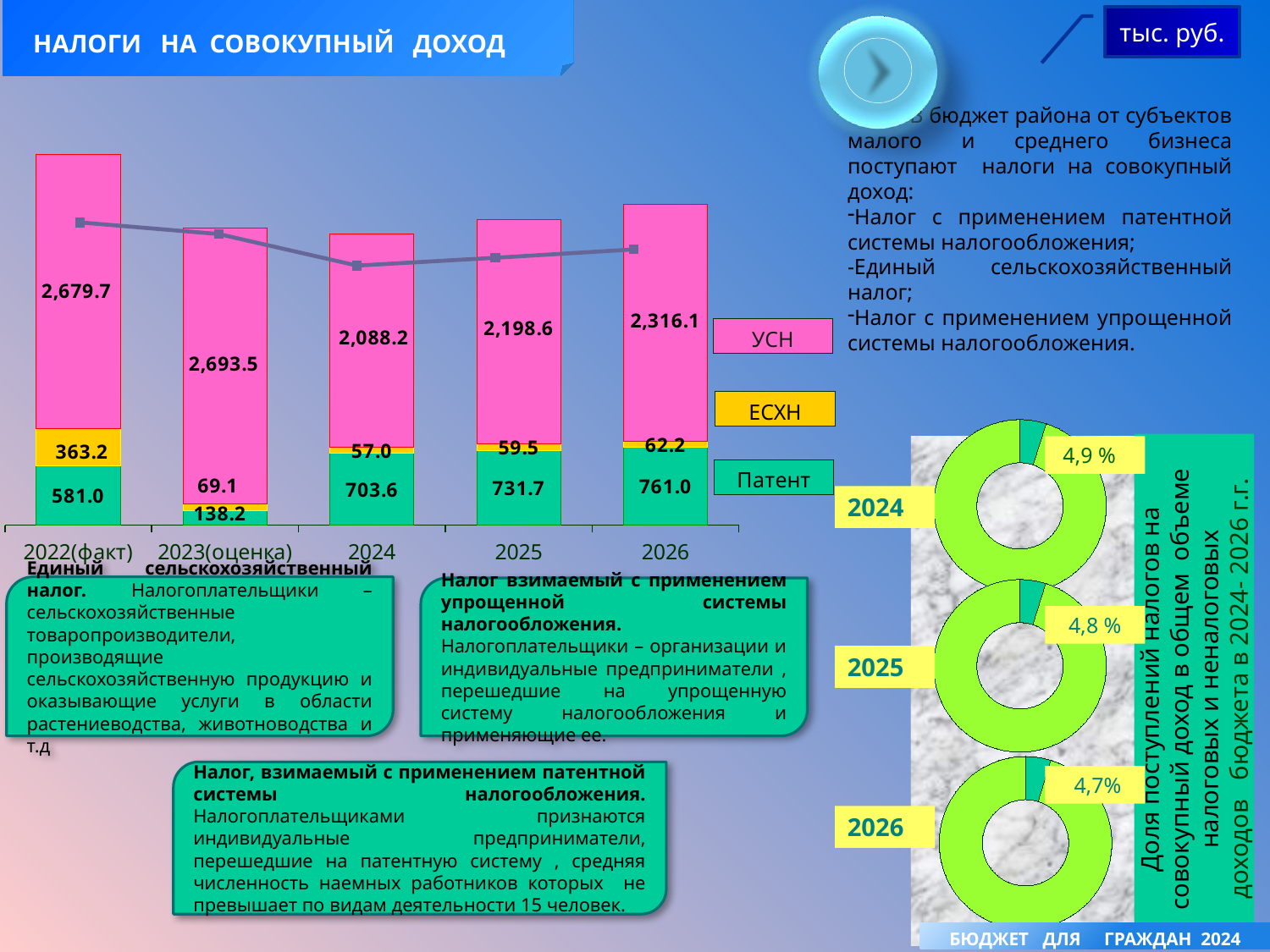
In the stacked bar chart, what is the difference between the УСН values for 2026 and 2025? 117.5 What kind of chart is the main chart on the left of the slide? Stacked bar chart In the stacked bar chart, which is larger: the Патент value for 2023(оценка) or for 2024? 2024 In the stacked bar chart, what is the ЕСХН value for 2023(оценка)? 69.1 In the stacked bar chart, which year has the highest Патент value? 2026 How many series does the legend of the stacked bar chart list? 3 In the stacked bar chart, which year has the lowest ЕСХН value? 2024 In the stacked bar chart, what is the УСН value for 2024? 2,088.2 In the stacked bar chart, what is the total of the 2024 bar (УСН + ЕСХН + Патент)? 2,848.8 In the donut charts on the right, what share is shown for 2025? 4,8 % In the stacked bar chart, what is the Патент value for 2022(факт)? 581.0 How many years (categories) are shown on the x axis of the stacked bar chart? 5